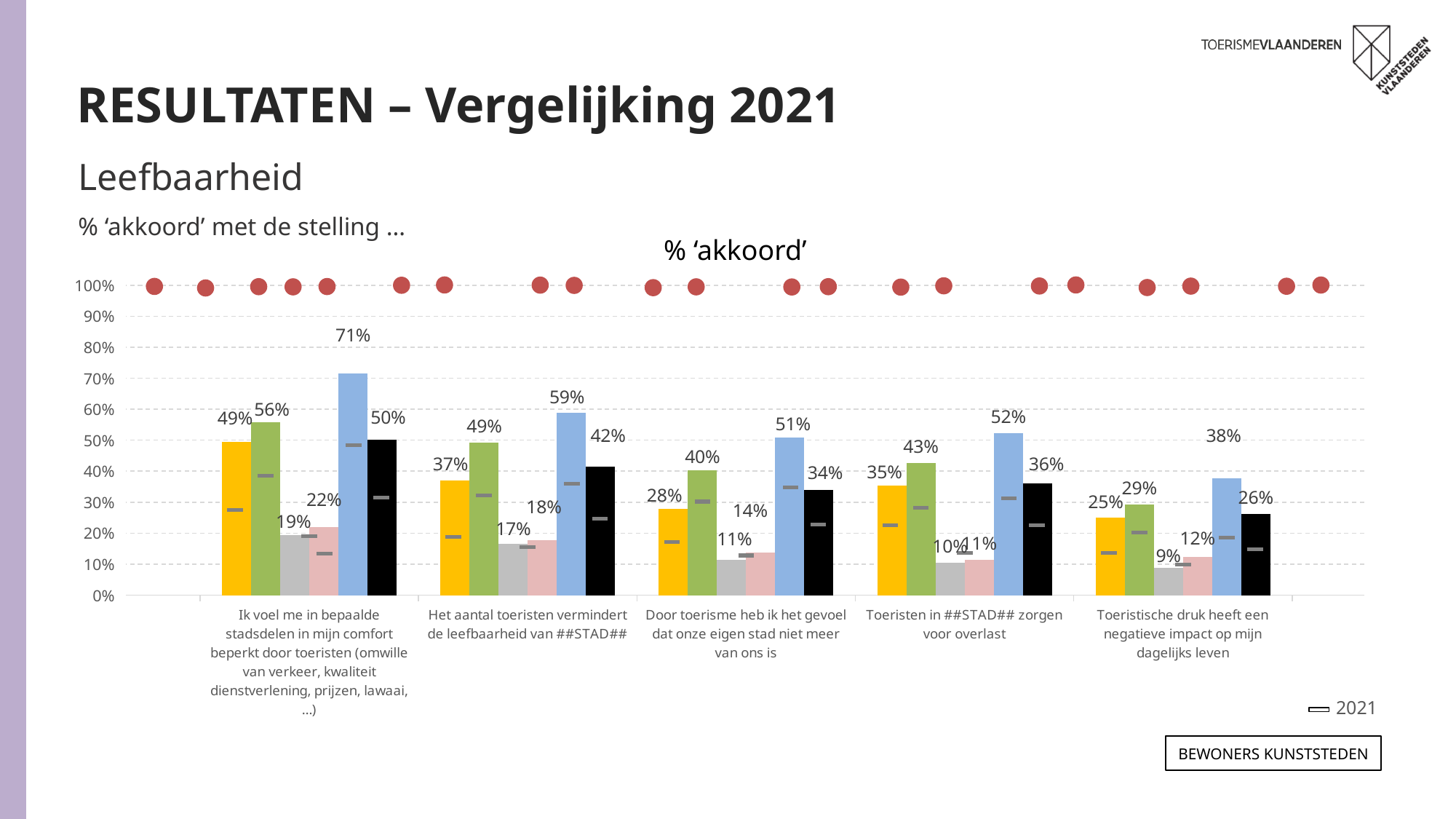
What is the value of the grey bar for "Door toerisme heb ik het gevoel dat onze eigen stad niet meer van ons is"? 11% What is the value of the green bar for "Toeristische druk heeft een negatieve impact op mijn dagelijks leven"? 29% How many statements (categories) are shown on the x axis? 5 Which statement has the highest blue bar? Ik voel me in bepaalde stadsdelen in mijn comfort beperkt door toeristen (omwille van verkeer, kwaliteit dienstverlening, prijzen, lawaai, ...) What is the difference between the blue bar and the yellow bar for "Het aantal toeristen vermindert de leefbaarheid van ##STAD##"? 22% Which statement has the lowest grey bar? Toeristische druk heeft een negatieve impact op mijn dagelijks leven For "Toeristen in ##STAD## zorgen voor overlast", which is larger: the green bar or the black bar? The green bar What kind of chart is shown on the slide? Bar chart What is the title of the chart? % 'akkoord' What is the value of the blue bar for the statement "Ik voel me in bepaalde stadsdelen in mijn comfort beperkt door toeristen"? 71% What is the value of the black bar for "Toeristen in ##STAD## zorgen voor overlast"? 36% What is the value of the yellow bar for "Het aantal toeristen vermindert de leefbaarheid van ##STAD##"? 37%